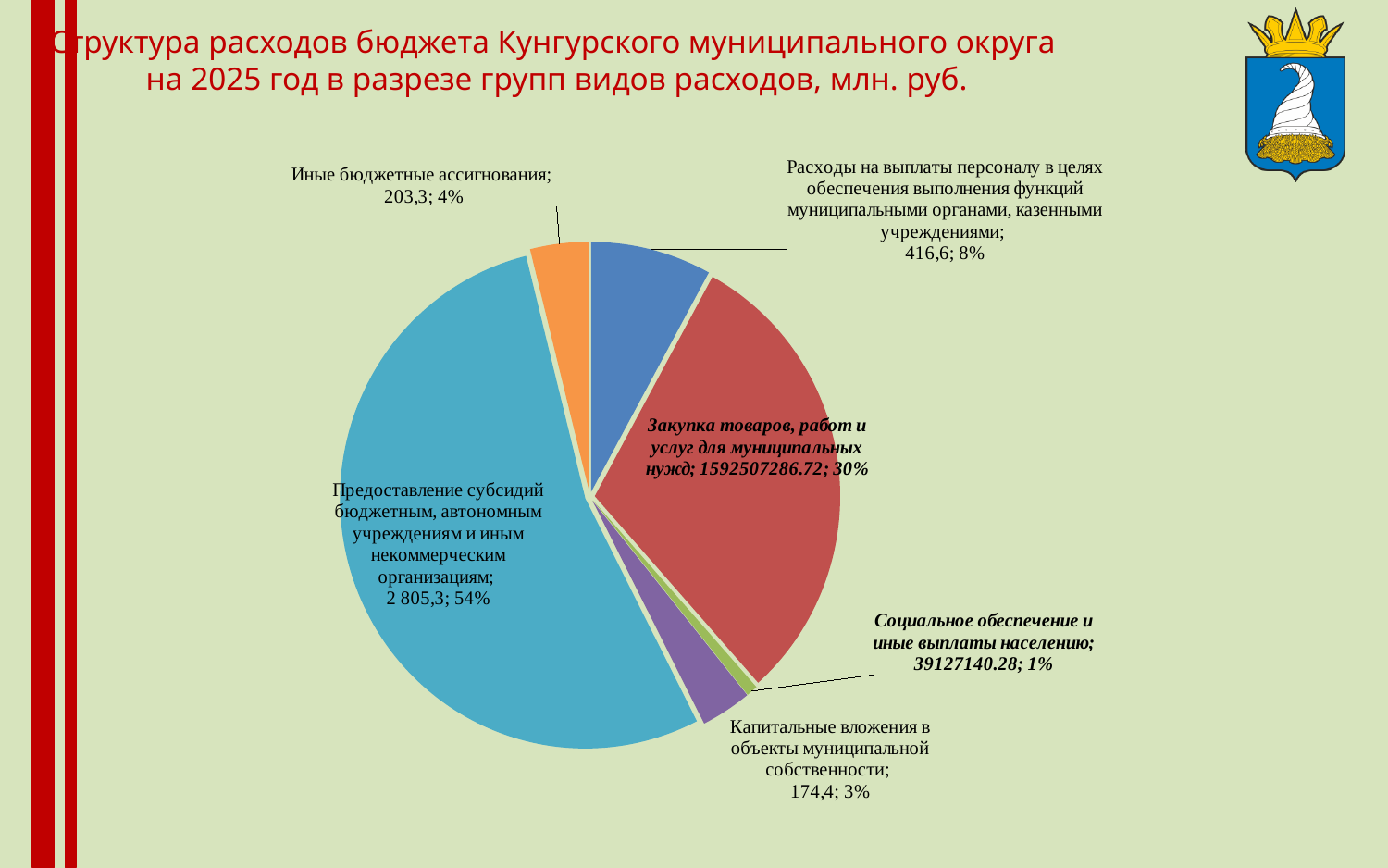
What value is shown for "Предоставление субсидий бюджетным, автономным учреждениям и иным некоммерческим организациям"? 2 805,3 What is the difference between the values for "Расходы на выплаты персоналу..." (416,6) and "Иные бюджетные ассигнования" (203,3)? 213,3 What value is shown for "Иные бюджетные ассигнования"? 203,3 What value is shown for "Социальное обеспечение и иные выплаты населению"? 39127140.28 Which category has the largest share of the pie? Предоставление субсидий бюджетным, автономным учреждениям и иным некоммерческим организациям Which is larger: the share for "Иные бюджетные ассигнования" or for "Капитальные вложения в объекты муниципальной собственности"? Иные бюджетные ассигнования What share of the pie does "Расходы на выплаты персоналу в целях обеспечения выполнения функций муниципальными органами, казенными учреждениями" represent? 8% What share of the pie does "Закупка товаров, работ и услуг для муниципальных нужд" represent? 30% Which category has the smallest share of the pie? Социальное обеспечение и иные выплаты населению What value is shown for "Капитальные вложения в объекты муниципальной собственности"? 174,4 How many slices does the pie chart have? 6 What kind of chart is shown on the slide? pie chart